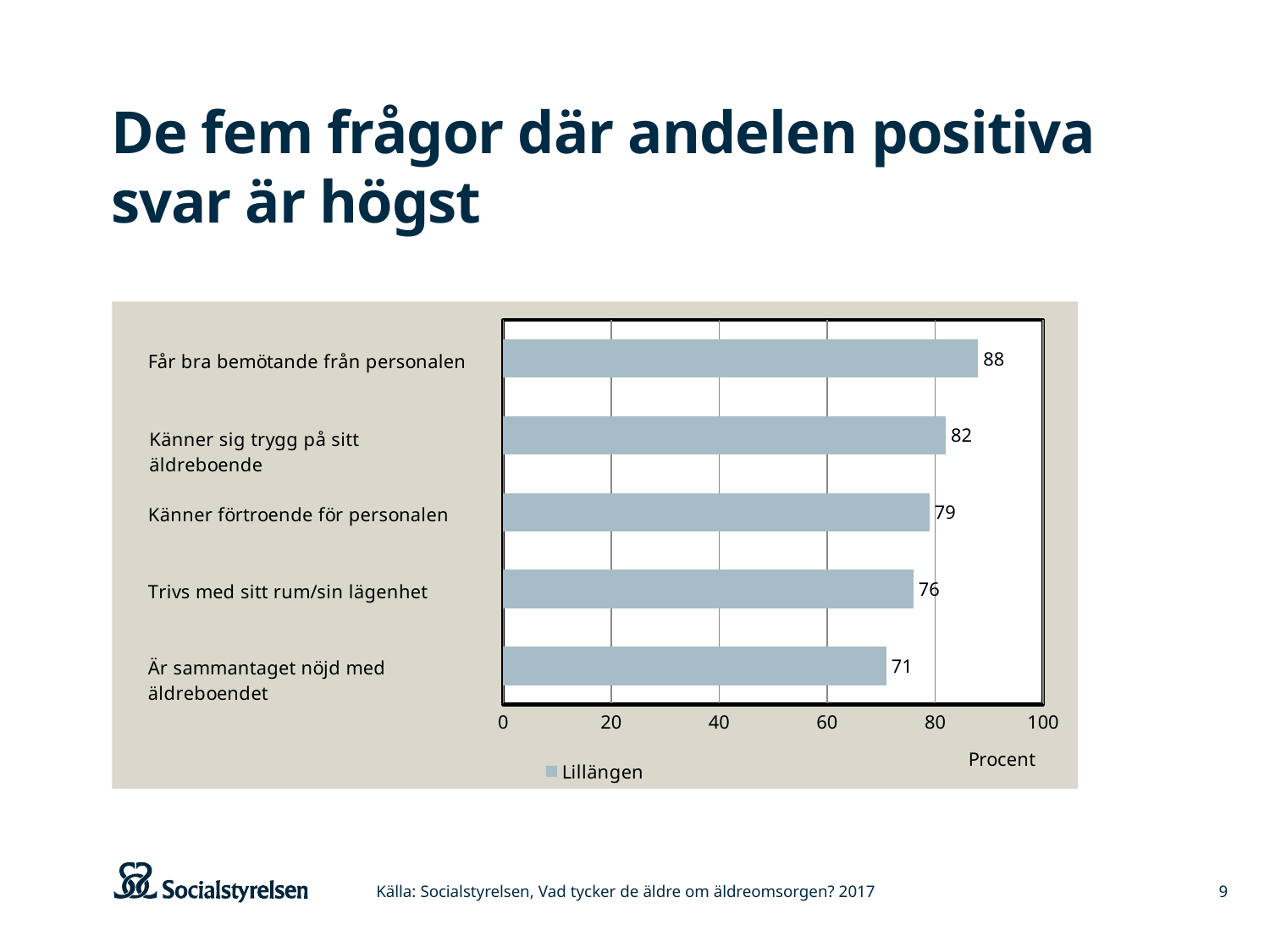
What series name is shown in the legend? Lillängen Which category has the highest value? Får bra bemötande från personalen Is the value for "Är sammantaget nöjd med äldreboendet" greater or less than 80? less Which category has the lowest value? Är sammantaget nöjd med äldreboendet What is the value for "Trivs med sitt rum/sin lägenhet"? 76 What kind of chart is shown on the slide? bar chart How many series does the legend list? 1 How many categories are shown in the chart? 5 What is the difference between the values for "Känner sig trygg på sitt äldreboende" and "Känner förtroende för personalen"? 3 What is the value for "Får bra bemötande från personalen"? 88 What is the value for "Är sammantaget nöjd med äldreboendet"? 71 Which is larger: the value for "Känner förtroende för personalen" or the value for "Trivs med sitt rum/sin lägenhet"? Känner förtroende för personalen